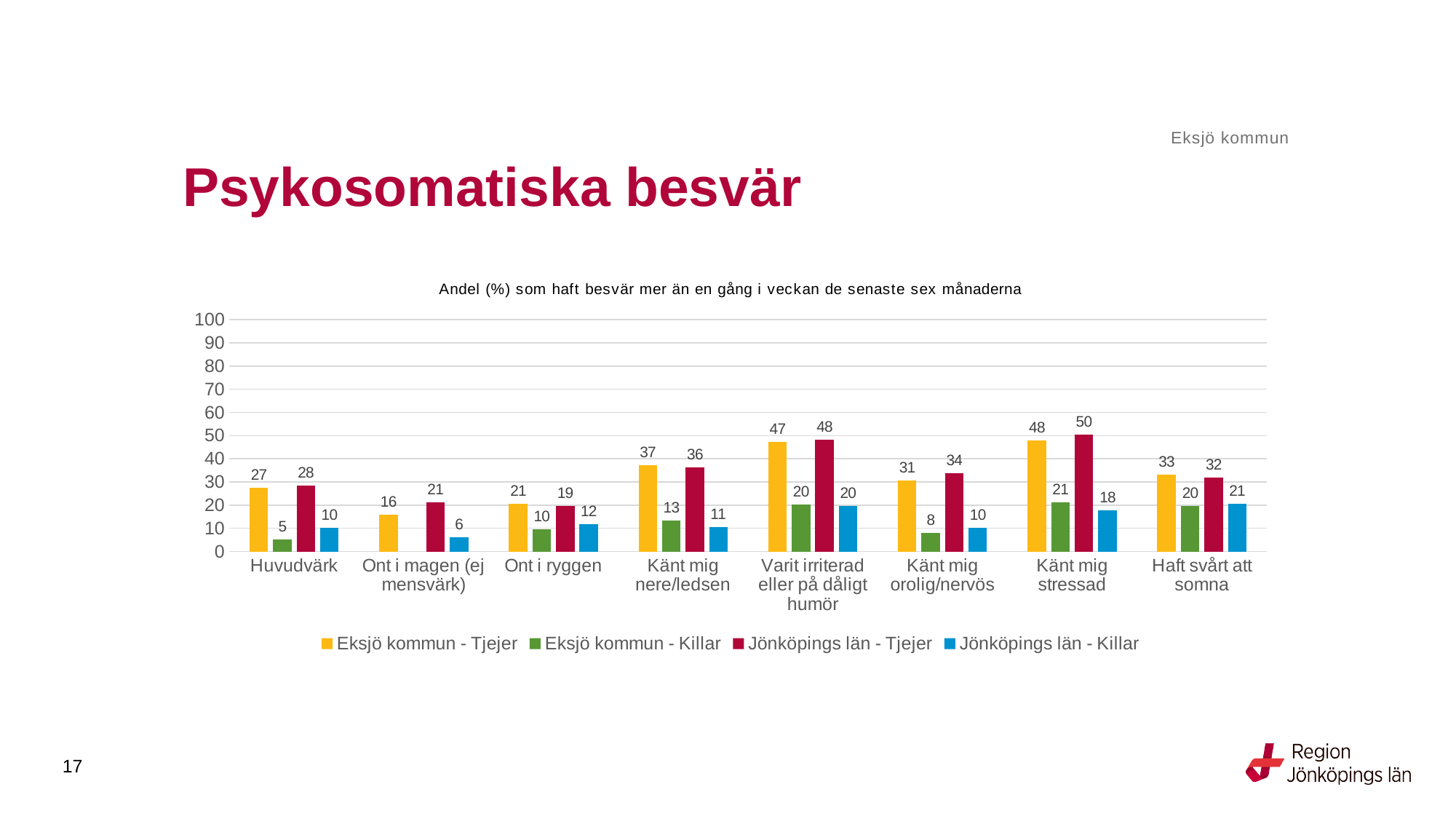
What kind of chart is shown on the slide? bar chart In the category Känt mig stressad, which is larger: Eksjö kommun - Killar or Jönköpings län - Killar? Eksjö kommun - Killar What is the value for Jönköpings län - Killar in the category Huvudvärk? 10 In which category does Jönköpings län - Tjejer have its highest value? Känt mig stressad What is the value for Eksjö kommun - Killar in the category Haft svårt att somna? 20 What is the value for Eksjö kommun - Tjejer in the category Känt mig stressad? 48 How many categories are shown on the x axis of the chart? 8 Is the value for Jönköpings län - Tjejer in the category Känt mig stressad greater or less than 40? greater How many series does the legend list? 4 What is the title printed above the chart? Andel (%) som haft besvär mer än en gång i veckan de senaste sex månaderna In which category does Eksjö kommun - Tjejer have its lowest value? Ont i magen (ej mensvärk) What is the difference between Eksjö kommun - Tjejer and Eksjö kommun - Killar in the category Känt mig nere/ledsen? 24